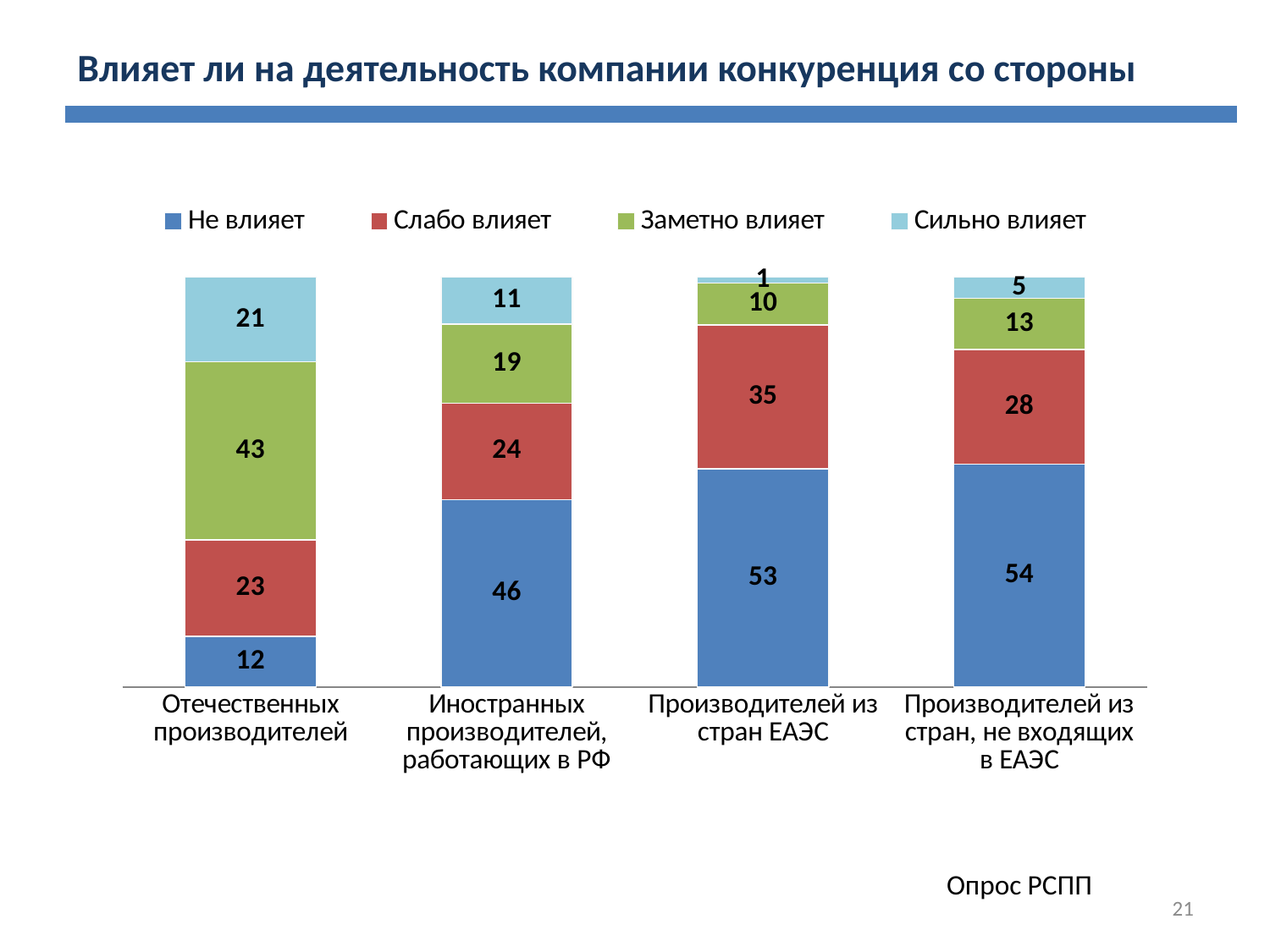
What is the value of "Заметно влияет" for "Иностранных производителей, работающих в РФ"? 19 Which is larger: "Слабо влияет" for "Производителей из стран ЕАЭС" or "Слабо влияет" for "Иностранных производителей, работающих в РФ"? Производителей из стран ЕАЭС How many series does the legend list? 4 What is the value of "Сильно влияет" for "Производителей из стран ЕАЭС"? 1 Which category has the lowest value for "Сильно влияет"? Производителей из стран ЕАЭС What is the total of the stacked bar for "Отечественных производителей"? 99 How many categories are shown on the x axis? 4 What is the value of "Слабо влияет" for "Производителей из стран, не входящих в ЕАЭС"? 28 Which category has the highest value for "Не влияет"? Производителей из стран, не входящих в ЕАЭС What is the difference between the "Заметно влияет" values for "Отечественных производителей" and "Производителей из стран ЕАЭС"? 33 What kind of chart is shown on the slide? Stacked bar chart What is the value of "Не влияет" for "Отечественных производителей"? 12